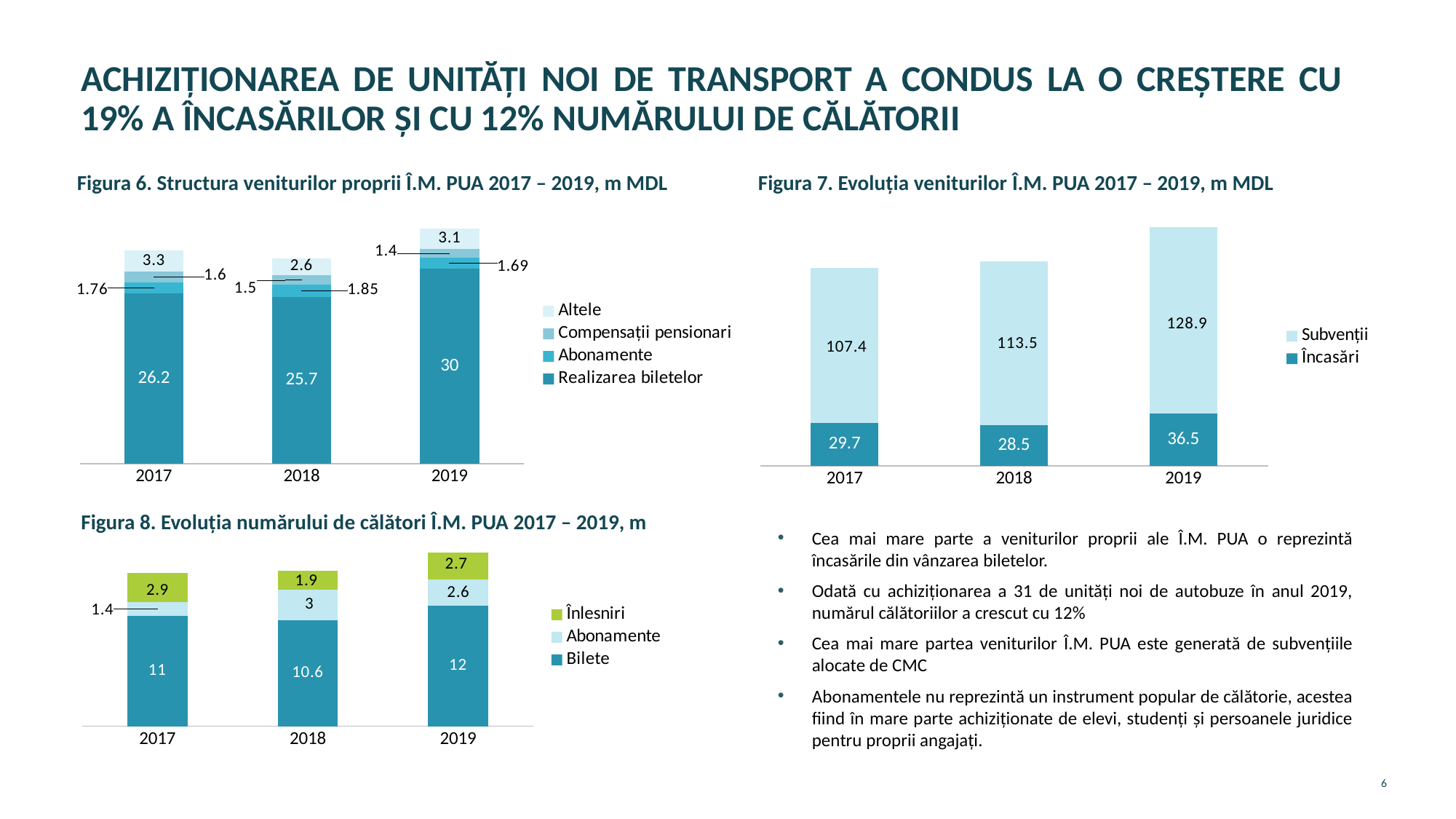
In Figura 7, what is the total of the stacked bar for 2017? 137.1 In Figura 6, how many series does the legend list? 4 In Figura 7, what is the value of Subvenții for 2019? 128.9 In Figura 8, what is the total of the stacked bar for 2019? 17.3 In Figura 6, what is the difference between Realizarea biletelor in 2019 and 2018? 4.3 In Figura 7, how many series does the legend list? 2 In Figura 7, what is the value of Încasări for 2018? 28.5 In Figura 7, which year has the lowest value for Încasări? 2018 In Figura 8, which is larger: Înlesniri in 2017 or Înlesniri in 2018? 2017 In Figura 6, what is the value of Altele for 2018? 2.6 In Figura 8, what is the value of Abonamente for 2018? 3 In Figura 6, what is the value of Realizarea biletelor for 2019? 30